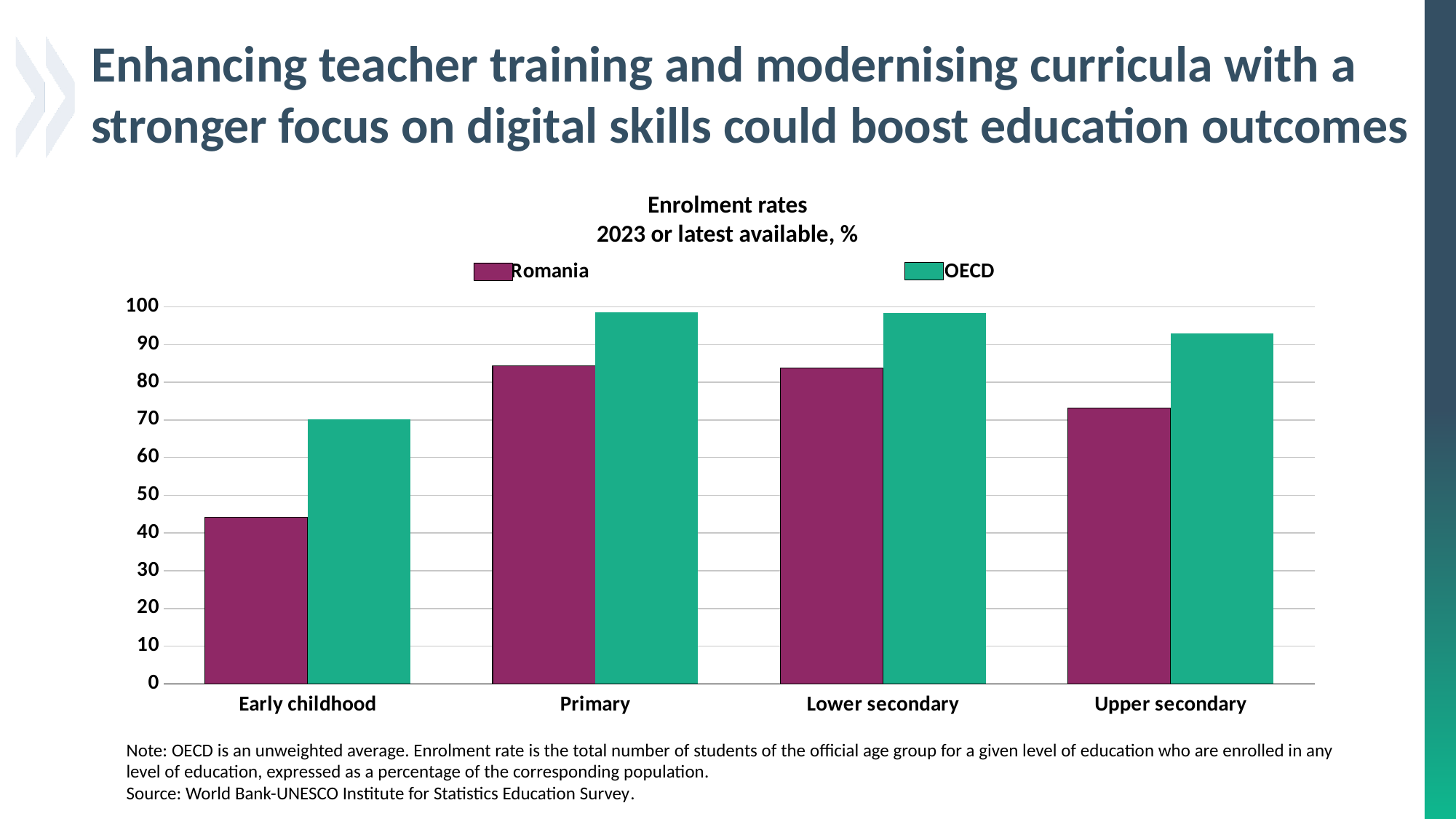
Is the OECD enrolment rate for Primary greater or less than 90? greater Is the OECD enrolment rate for Early childhood greater or less than 60? greater How many education levels are shown on the x axis? 4 What kind of chart is shown on the slide? bar chart How many series does the legend list? 2 Which education level has the lowest enrolment rate for Romania? Early childhood Is the Romania enrolment rate for Early childhood greater or less than 50? less For Romania, which is larger: the enrolment rate for Early childhood or for Upper secondary? Upper secondary For Early childhood, which is larger: the Romania or the OECD enrolment rate? OECD Which education level has the lowest enrolment rate for the OECD? Early childhood What is the title of the chart? Enrolment rates 2023 or latest available, %